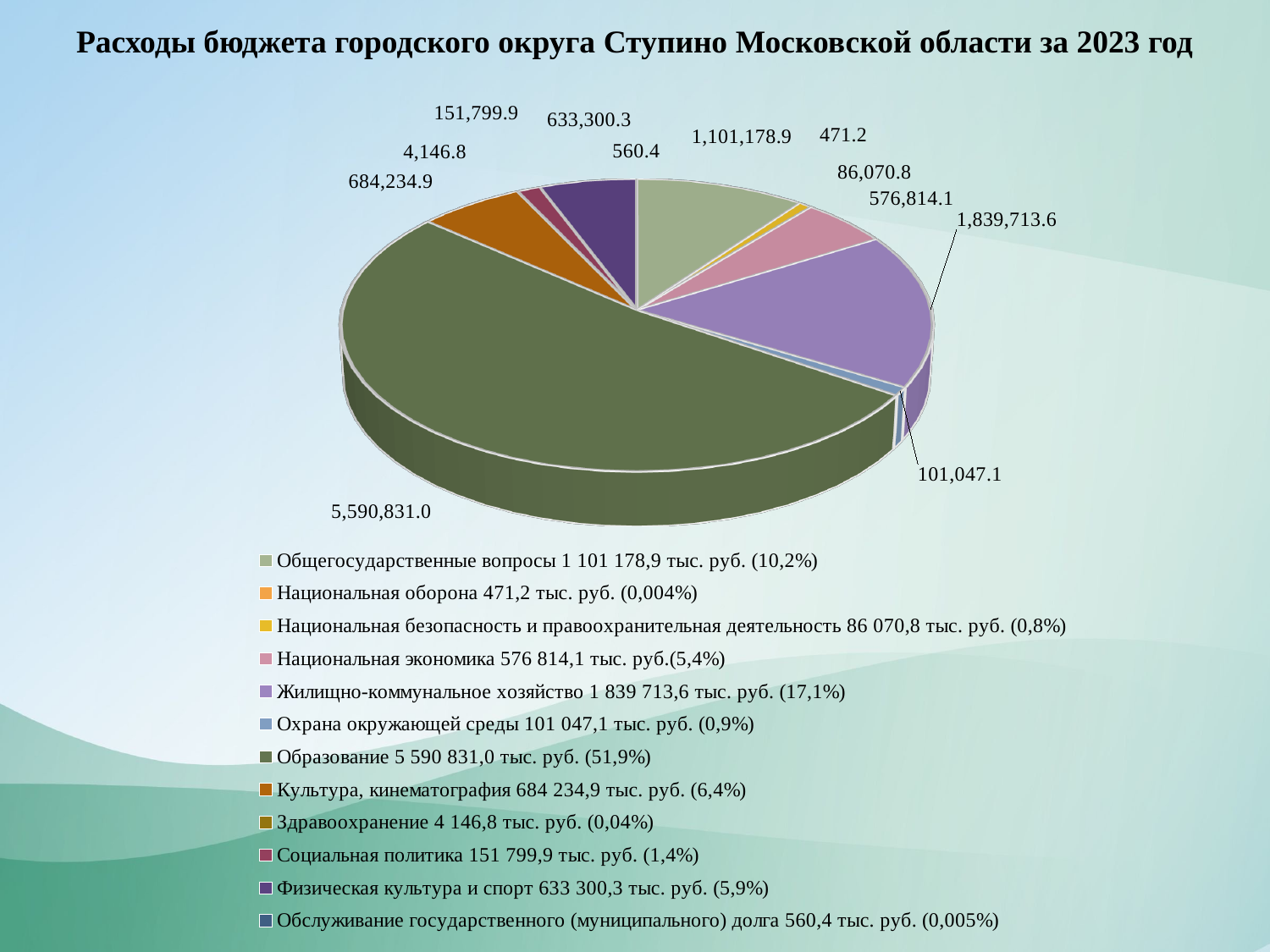
Which category has the smallest value? Национальная оборона How many categories does the pie chart have? 12 What is the value for Охрана окружающей среды? 101,047.1 What share of the pie does Жилищно-коммунальное хозяйство account for, according to the legend? 17,1% What is the value for Социальная политика? 151,799.9 Which is larger: the value for Культура, кинематография or the value for Физическая культура и спорт? Культура, кинематография What share of the pie does Образование account for, according to the legend? 51,9% Which category has the largest slice of the pie? Образование What kind of chart is shown on the slide? pie chart What is the title of the chart? Расходы бюджета городского округа Ступино Московской области за 2023 год What is the difference between the values for Жилищно-коммунальное хозяйство and Общегосударственные вопросы? 738,534.7 What is the value for Образование? 5,590,831.0